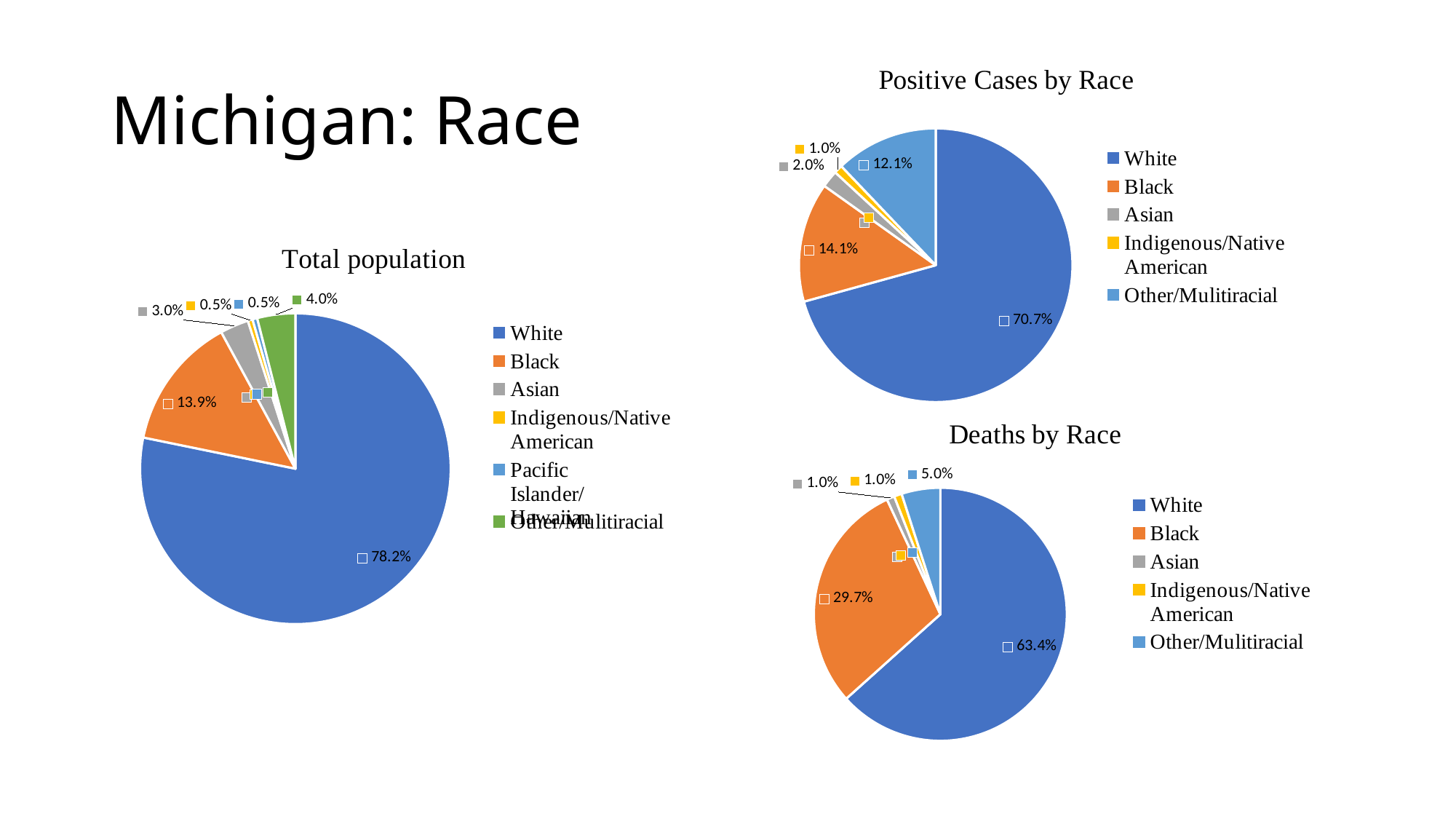
In the Positive Cases by Race chart, what is the value for Black? 14.1% In the Total population chart, what share of the pie is White? 78.2% In the Total population chart, which is larger, the Asian slice or the Other/Mulitiracial slice? Other/Mulitiracial How many categories does the legend of the Deaths by Race chart list? 5 In the Deaths by Race chart, what is the value for Other/Mulitiracial? 5.0% What kind of chart is the Positive Cases by Race chart? Pie chart In the Deaths by Race chart, which category has the largest slice? White In the Deaths by Race chart, what is the difference between the White and Black values? 33.7% In the Positive Cases by Race chart, what is the value for Other/Mulitiracial? 12.1% What is the title of the chart at the bottom right of the slide? Deaths by Race How many categories does the legend of the Total population chart list? 6 In the Positive Cases by Race chart, which category has the smallest slice? Indigenous/Native American